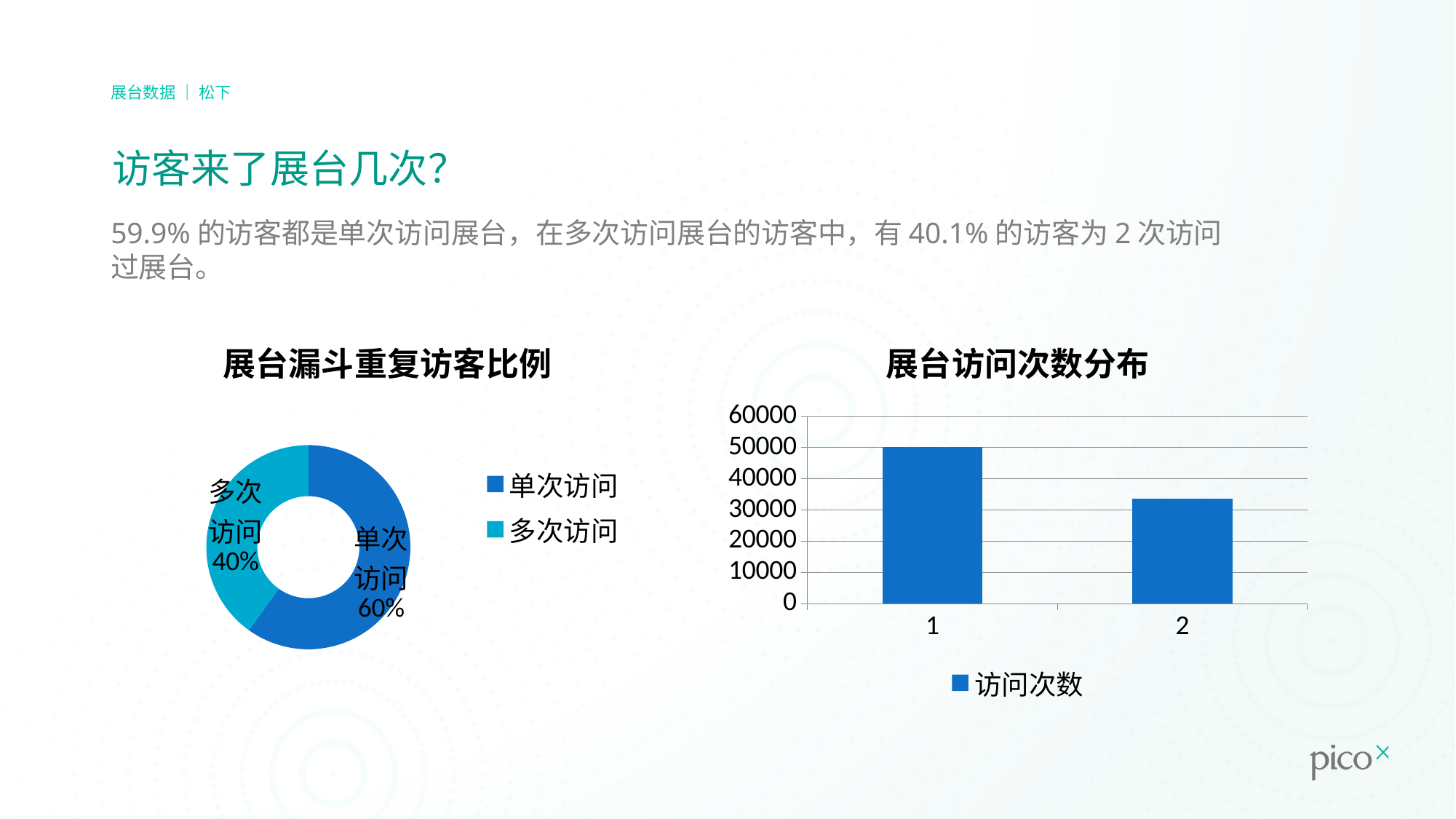
In the chart titled 展台访问次数分布, is the value for category 1 greater or less than 40000? greater In the chart titled 展台访问次数分布, what series name does the legend show? 访问次数 In the chart titled 展台访问次数分布, is the value for category 2 greater or less than 30000? greater In the chart titled 展台漏斗重复访客比例, what is the difference in percentage points between 单次访问 and 多次访问? 20% In the chart titled 展台访问次数分布, which category has the highest bar? 1 What kind of chart is the one titled 展台漏斗重复访客比例? Donut (pie) chart In the chart titled 展台漏斗重复访客比例, what share of the donut is 多次访问? 40% In the chart titled 展台漏斗重复访客比例, which slice is larger, 单次访问 or 多次访问? 单次访问 In the chart titled 展台漏斗重复访客比例, how many slices does the donut have? 2 In the chart titled 展台访问次数分布, which category has the lowest bar? 2 In the chart titled 展台漏斗重复访客比例, what share of the donut is 单次访问? 60% What kind of chart is the one titled 展台访问次数分布? Bar chart